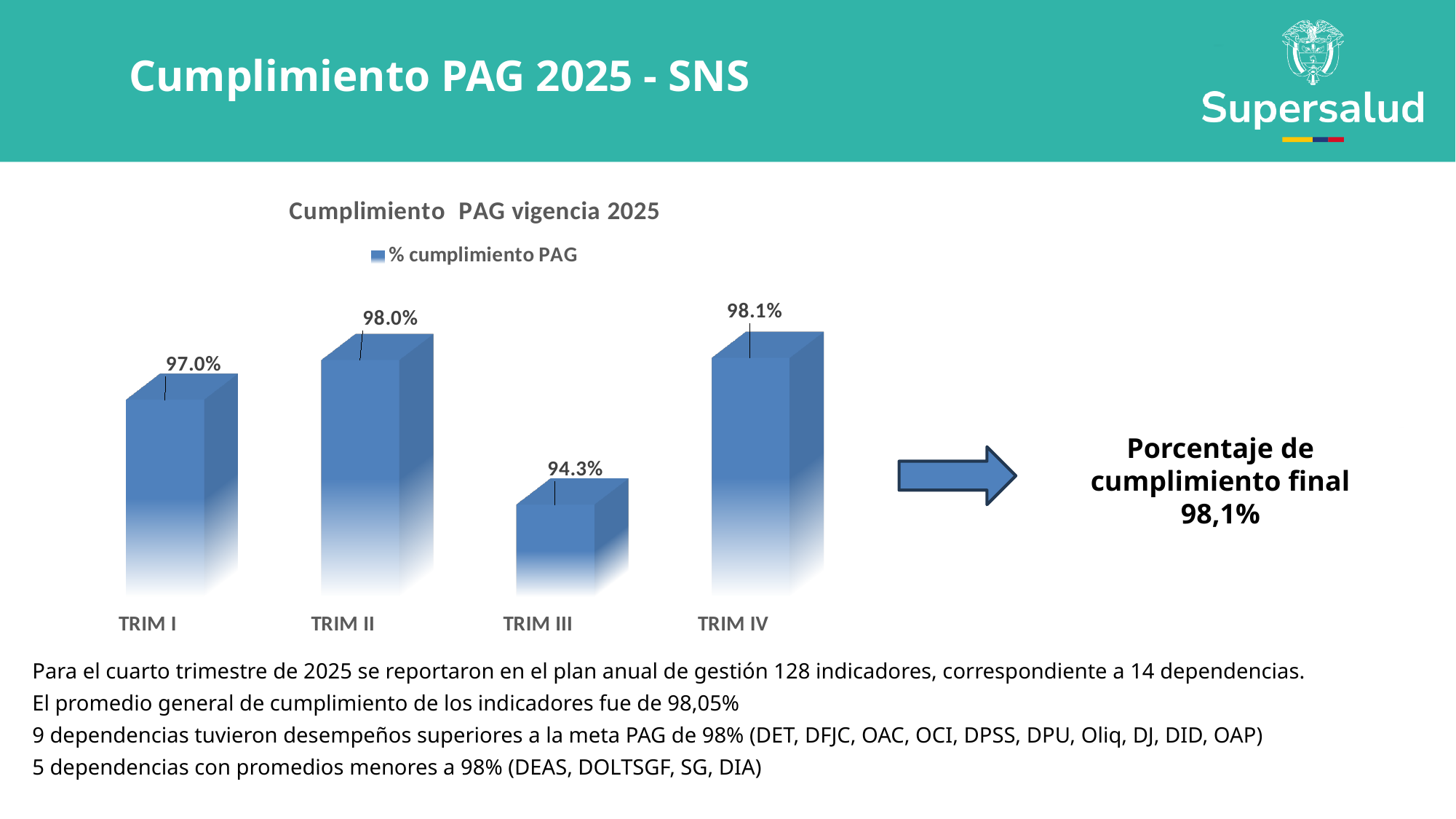
How many trimesters are shown on the chart? 4 Which has a higher % cumplimiento PAG, TRIM I or TRIM III? TRIM I Which trimester has the lowest % cumplimiento PAG? TRIM III What is the % cumplimiento PAG value for TRIM IV? 98.1% What is the % cumplimiento PAG value for TRIM II? 98.0% What is the % cumplimiento PAG value for TRIM I? 97.0% What is the title of the chart? Cumplimiento PAG vigencia 2025 What is the difference between the % cumplimiento PAG for TRIM II and TRIM III? 3.7% Which trimester has the highest % cumplimiento PAG? TRIM IV What kind of chart is shown on the slide? Bar chart What is the % cumplimiento PAG value for TRIM III? 94.3% How many series does the legend list? 1